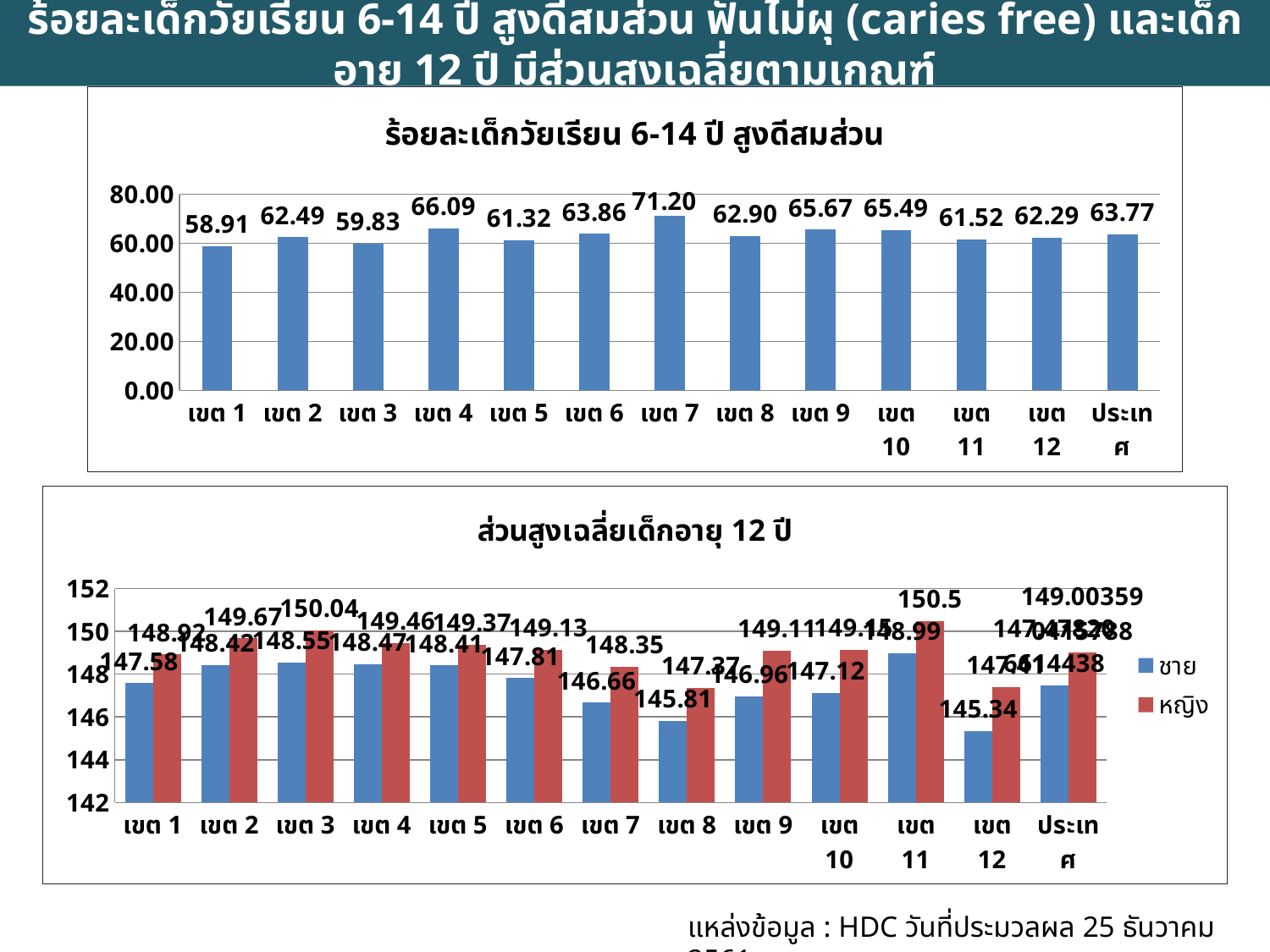
In the bottom chart 'ส่วนสูงเฉลี่ยเด็กอายุ 12 ปี', which is larger in เขต 3: ชาย or หญิง? หญิง In the top chart 'ร้อยละเด็กวัยเรียน 6-14 ปี สูงดีสมส่วน', which category has the lowest value? เขต 1 In the top chart 'ร้อยละเด็กวัยเรียน 6-14 ปี สูงดีสมส่วน', what is the value for เขต 7? 71.20 In the bottom chart 'ส่วนสูงเฉลี่ยเด็กอายุ 12 ปี', what is the difference between หญิง and ชาย in เขต 1? 1.34 What kind of chart is the bottom chart 'ส่วนสูงเฉลี่ยเด็กอายุ 12 ปี'? bar chart In the bottom chart 'ส่วนสูงเฉลี่ยเด็กอายุ 12 ปี', what is the value for หญิง in เขต 11? 150.5 In the bottom chart 'ส่วนสูงเฉลี่ยเด็กอายุ 12 ปี', how many series does the legend list? 2 In the top chart 'ร้อยละเด็กวัยเรียน 6-14 ปี สูงดีสมส่วน', which category has the highest value? เขต 7 In the top chart 'ร้อยละเด็กวัยเรียน 6-14 ปี สูงดีสมส่วน', how many categories are shown on the x axis? 13 In the top chart 'ร้อยละเด็กวัยเรียน 6-14 ปี สูงดีสมส่วน', what is the difference between เขต 7 and เขต 1? 12.29 In the top chart 'ร้อยละเด็กวัยเรียน 6-14 ปี สูงดีสมส่วน', what is the value for ประเทศ? 63.77 In the bottom chart 'ส่วนสูงเฉลี่ยเด็กอายุ 12 ปี', what is the value for ชาย in เขต 8? 145.81